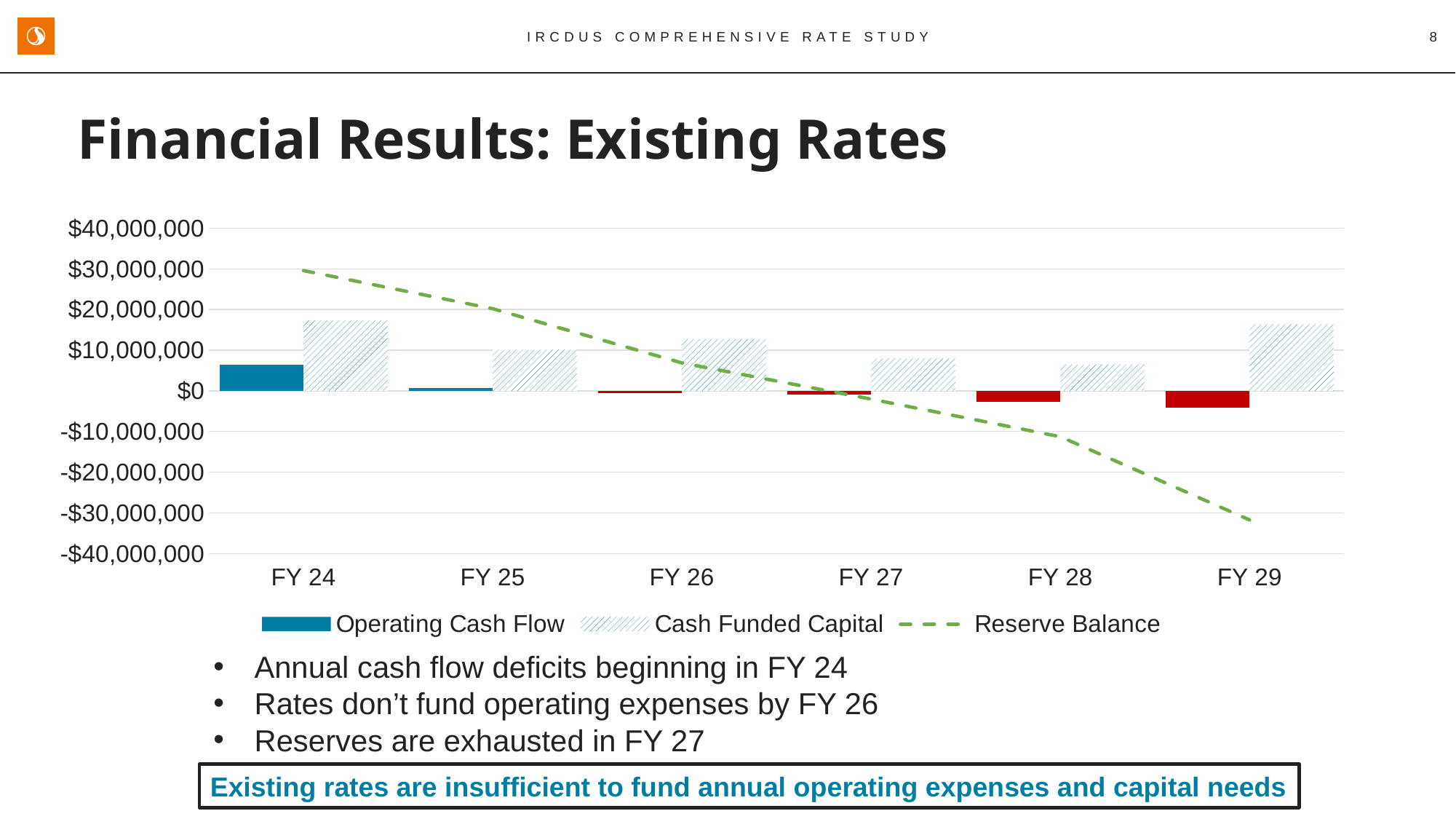
Which series is shown as a green dashed line in the chart? Reserve Balance Is the Cash Funded Capital value for FY 24 greater or less than $10,000,000? greater Is the Cash Funded Capital value for FY 28 greater or less than $10,000,000? less Is the Reserve Balance for FY 24 greater or less than $20,000,000? greater In which fiscal year is Operating Cash Flow lowest? FY 29 Does the Reserve Balance rise or fall from FY 24 to FY 29? It falls What kind of chart is shown on the slide? A bar chart combined with a dashed line How many fiscal years are shown on the x axis of the chart? 6 How many series does the chart's legend list? 3 Which is larger, the Cash Funded Capital for FY 26 or for FY 27? FY 26 In which fiscal year is Operating Cash Flow highest? FY 24